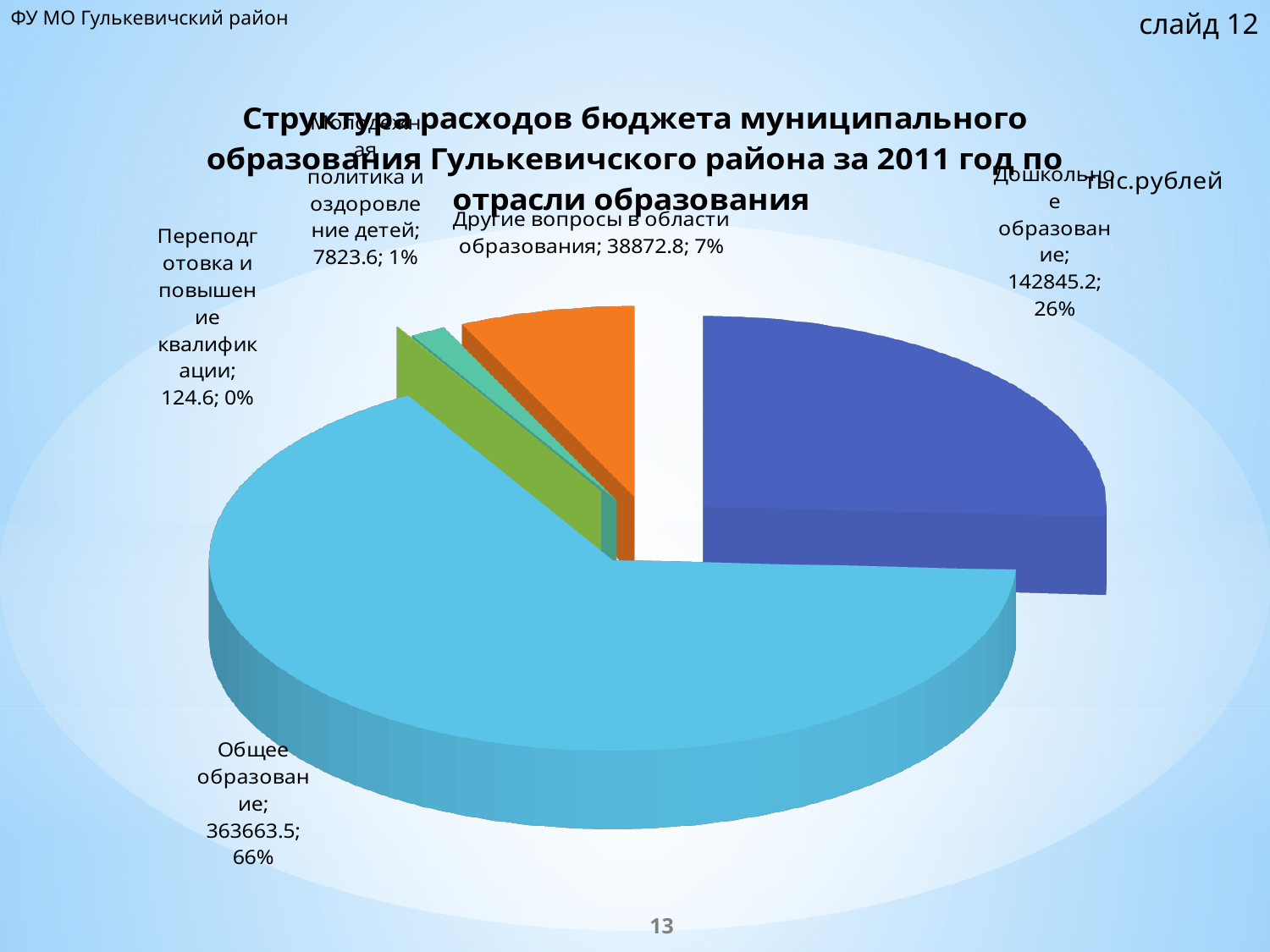
How many slices does the pie chart have? 5 What unit is stated for the values in the chart? тыс.рублей What share of the pie does Общее образование take? 66% What is the value for Дошкольное образование? 142845.2 What is the value for Другие вопросы в области образования? 38872.8 Which category has the largest slice? Общее образование What share of the pie does Дошкольное образование take? 26% What is the value for Молодежная политика и оздоровление детей? 7823.6 Which category has the smallest slice? Переподготовка и повышение квалификации What kind of chart is shown on the slide? pie chart Which is larger, Дошкольное образование or Другие вопросы в области образования? Дошкольное образование What is the value for Общее образование? 363663.5